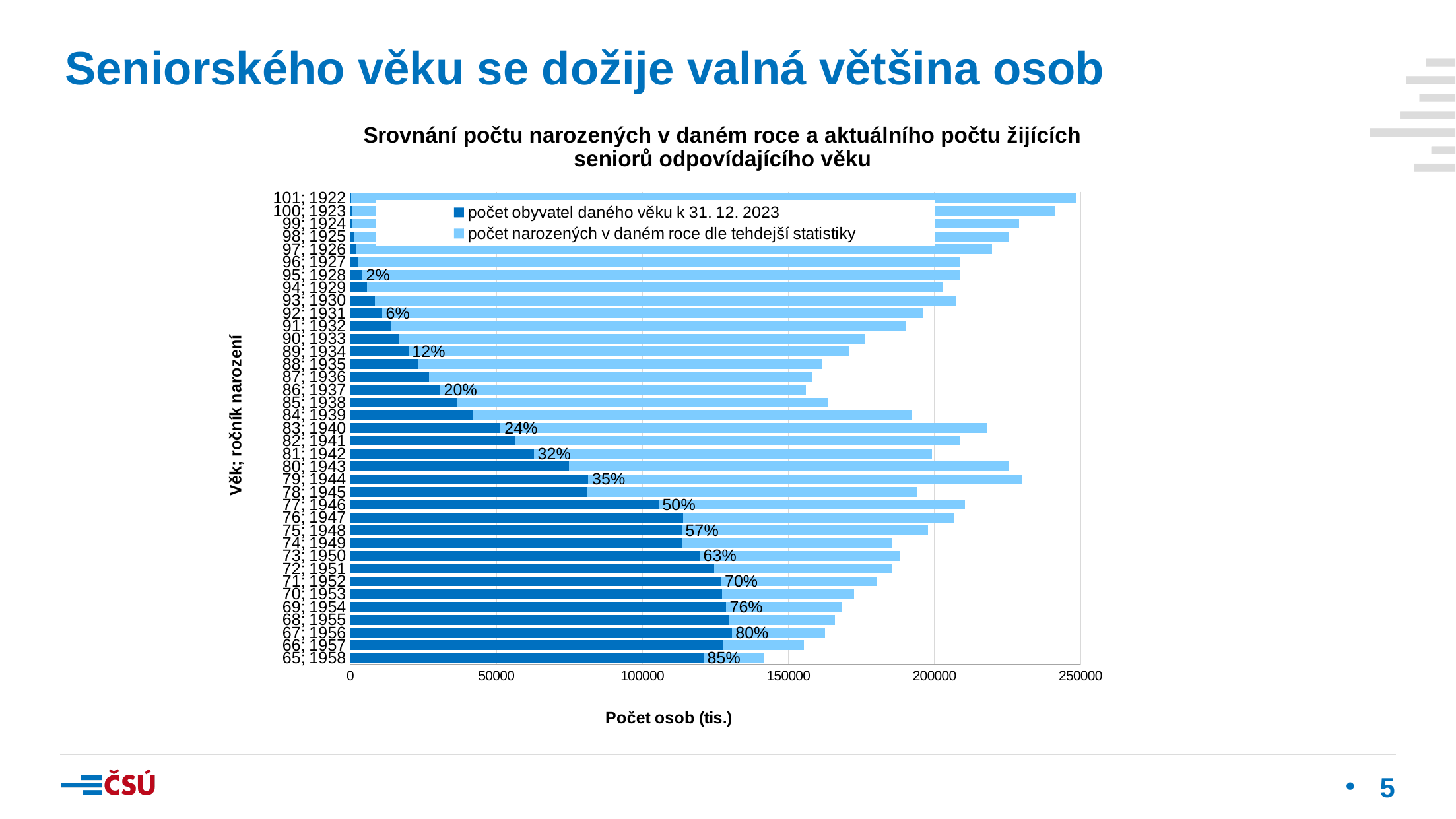
What percentage label is shown for the category 65; 1958? 85% Which category has the highest value for 'počet narozených v daném roce dle tehdejší statistiky'? 101; 1922 What kind of chart is shown on the slide? bar chart What percentage label is shown for the category 95; 1928? 2% Which category has the lowest value for 'počet obyvatel daného věku k 31. 12. 2023'? 101; 1922 Which is larger: 'počet obyvatel daného věku k 31. 12. 2023' for 77; 1946 or for 95; 1928? 77; 1946 How many age/birth-year categories are plotted on the y axis? 37 What percentage label is shown for the category 83; 1940? 24% How many series does the legend list? 2 What percentage label is shown for the category 77; 1946? 50% What is the title of the x axis? Počet osob (tis.) Is the value of 'počet narozených v daném roce' for 101; 1922 greater or less than 200000? greater